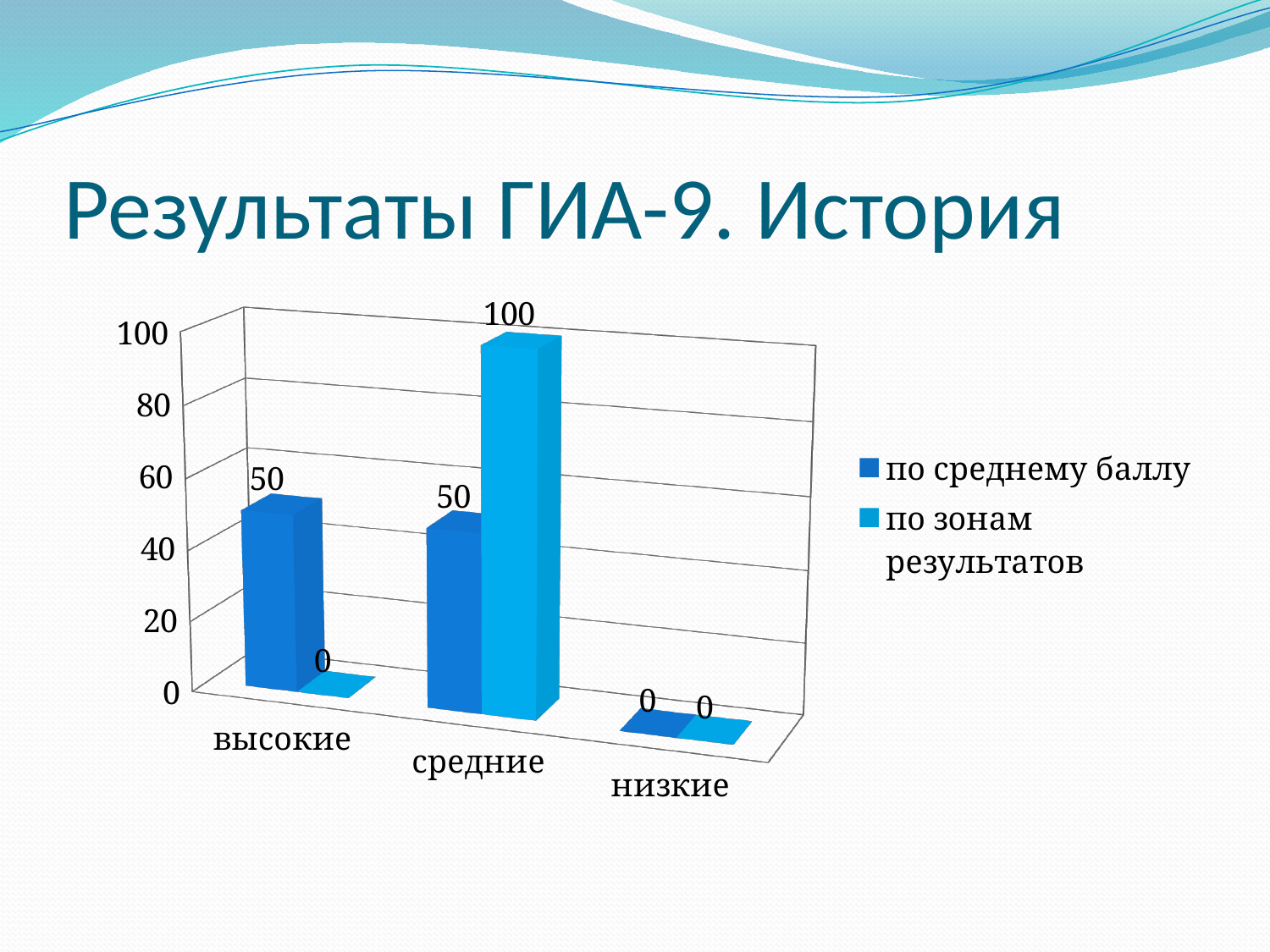
What is the value for "высокие" in the "по зонам результатов" series? 0 What kind of chart is shown on the slide? bar chart For "средние", which series has the larger value: "по среднему баллу" or "по зонам результатов"? по зонам результатов What is the value for "низкие" in the "по среднему баллу" series? 0 Which category has the lowest value in the "по среднему баллу" series? низкие How many series does the legend list? 2 What is the difference between the "по зонам результатов" value and the "по среднему баллу" value for "средние"? 50 What is the title of the slide? Результаты ГИА-9. История Which category has the highest value in the "по зонам результатов" series? средние What is the value for "средние" in the "по зонам результатов" series? 100 How many categories are shown on the x axis? 3 What is the value for "высокие" in the "по среднему баллу" series? 50